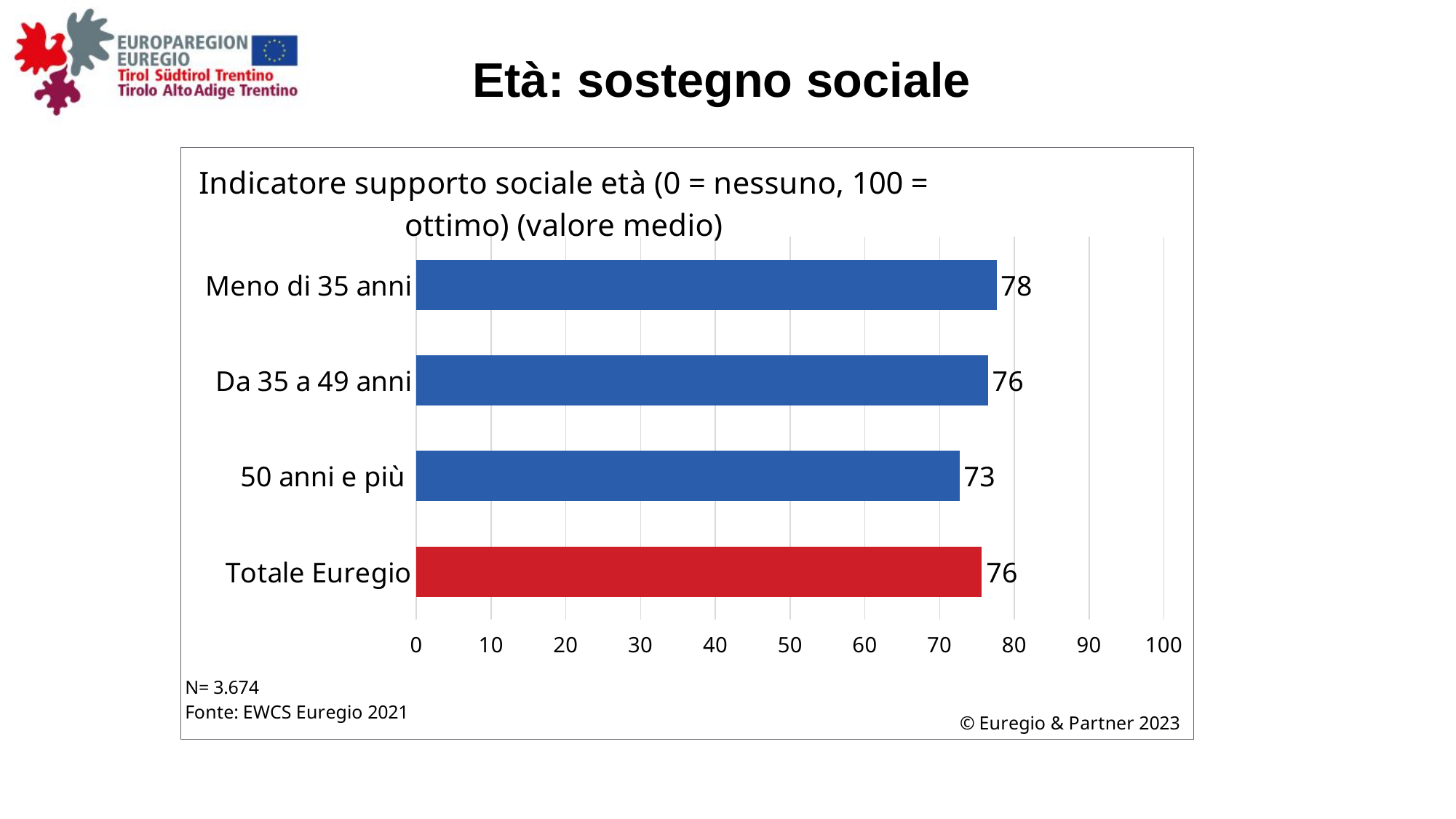
What is the value for Totale Euregio? 76 What is the value for Da 35 a 49 anni? 76 What is the value for Meno di 35 anni? 78 Which category has the highest value? Meno di 35 anni How many categories are shown in the chart? 4 Is the value for 50 anni e più greater or less than 80? less Which is larger, the value for Meno di 35 anni or the value for 50 anni e più? Meno di 35 anni What kind of chart is shown on the slide? bar chart What is the value for 50 anni e più? 73 What is the difference between the values for Meno di 35 anni and 50 anni e più? 5 Which category has the lowest value? 50 anni e più Which category is shown with a red bar? Totale Euregio